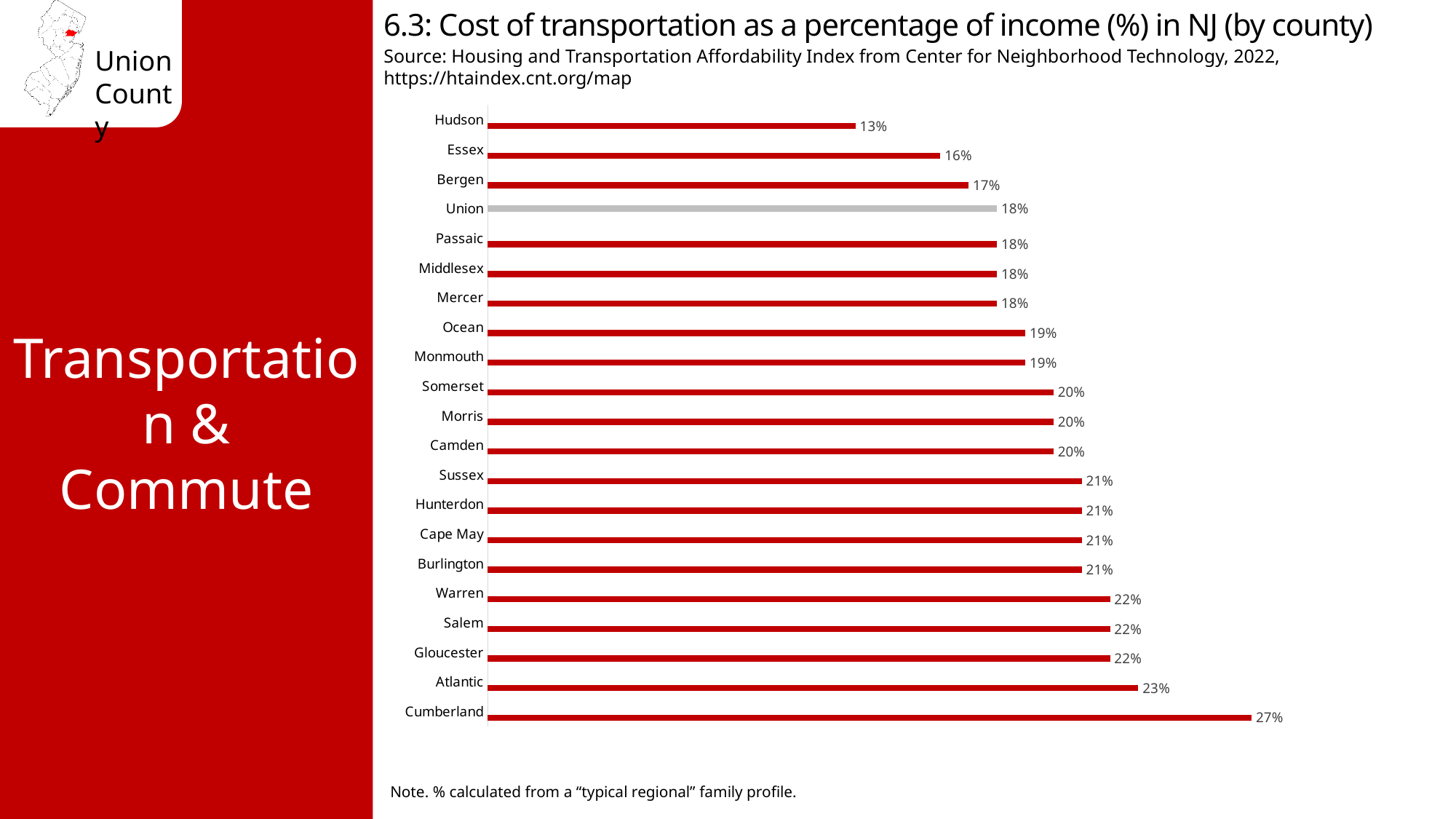
What is the value shown for Somerset County? 20% How many counties are shown in the chart? 21 Which county has the lowest cost of transportation as a percentage of income? Hudson Which county has the highest cost of transportation as a percentage of income? Cumberland What type of chart is shown on the slide? Bar chart What is the difference in percentage points between Union and Essex? 2 What is the cost of transportation as a percentage of income for Hudson County? 13% What is the difference in percentage points between Cumberland and Hudson? 14 What is the cost of transportation as a percentage of income for Atlantic County? 23% Which county's bar is shown in a different colour (grey) from the others? Union Which has a higher cost of transportation as a percentage of income, Bergen or Warren? Warren What is the cost of transportation as a percentage of income for Union County? 18%